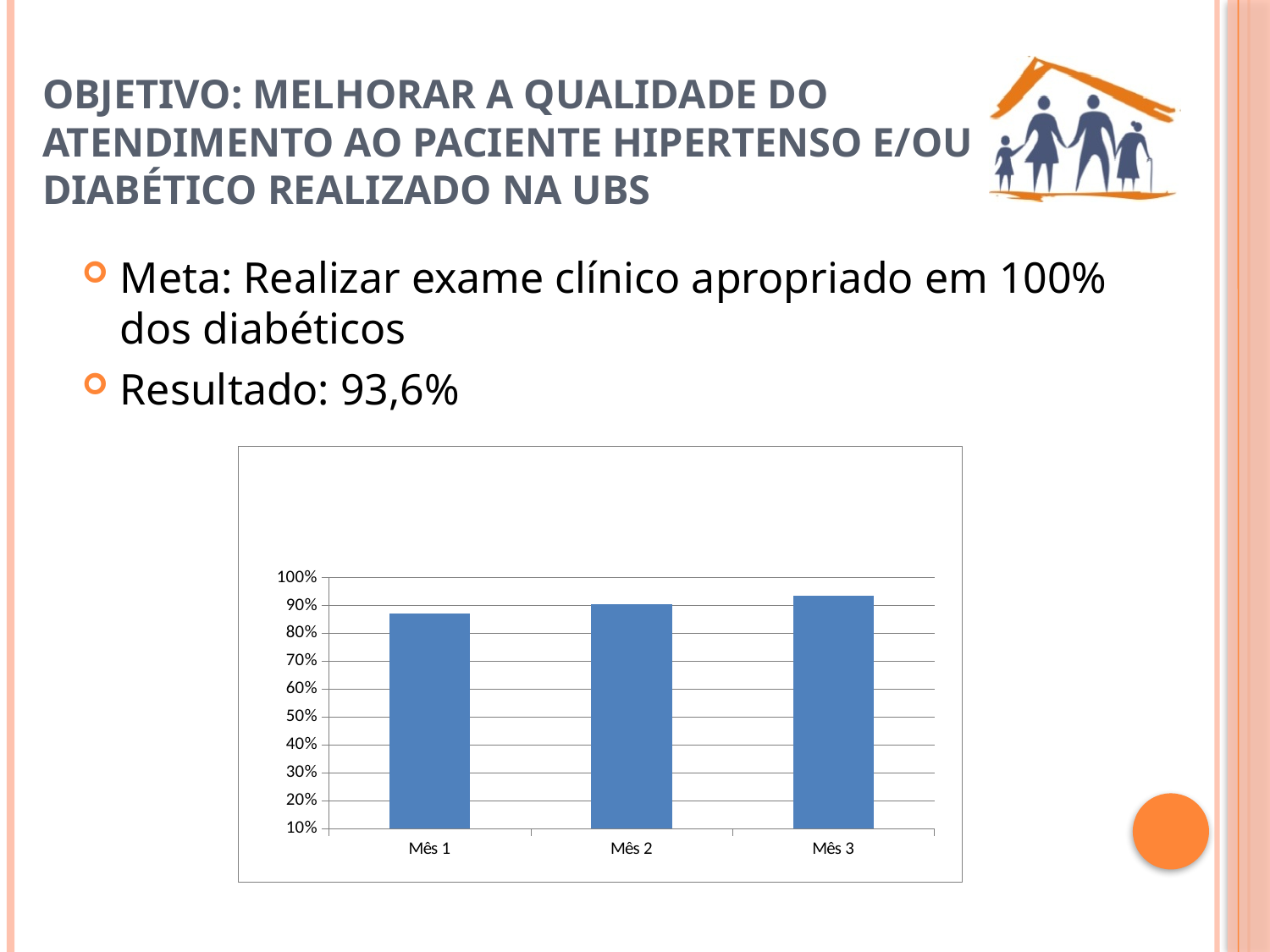
What kind of chart is shown on the slide? bar chart Is the value for Mês 3 greater or less than 100%? less How many categories are plotted on the x axis of the chart? 3 What is the lowest tick label shown on the y axis of the chart? 10% Do the bar values rise or fall from Mês 1 to Mês 3? rise Which is larger, the value for Mês 1 or the value for Mês 3? Mês 3 Is the value for Mês 1 greater or less than 90%? less Is the value for Mês 1 greater or less than 80%? greater Which category has the lowest bar in the chart? Mês 1 What colour are the bars in the chart? blue Which category has the highest bar in the chart? Mês 3